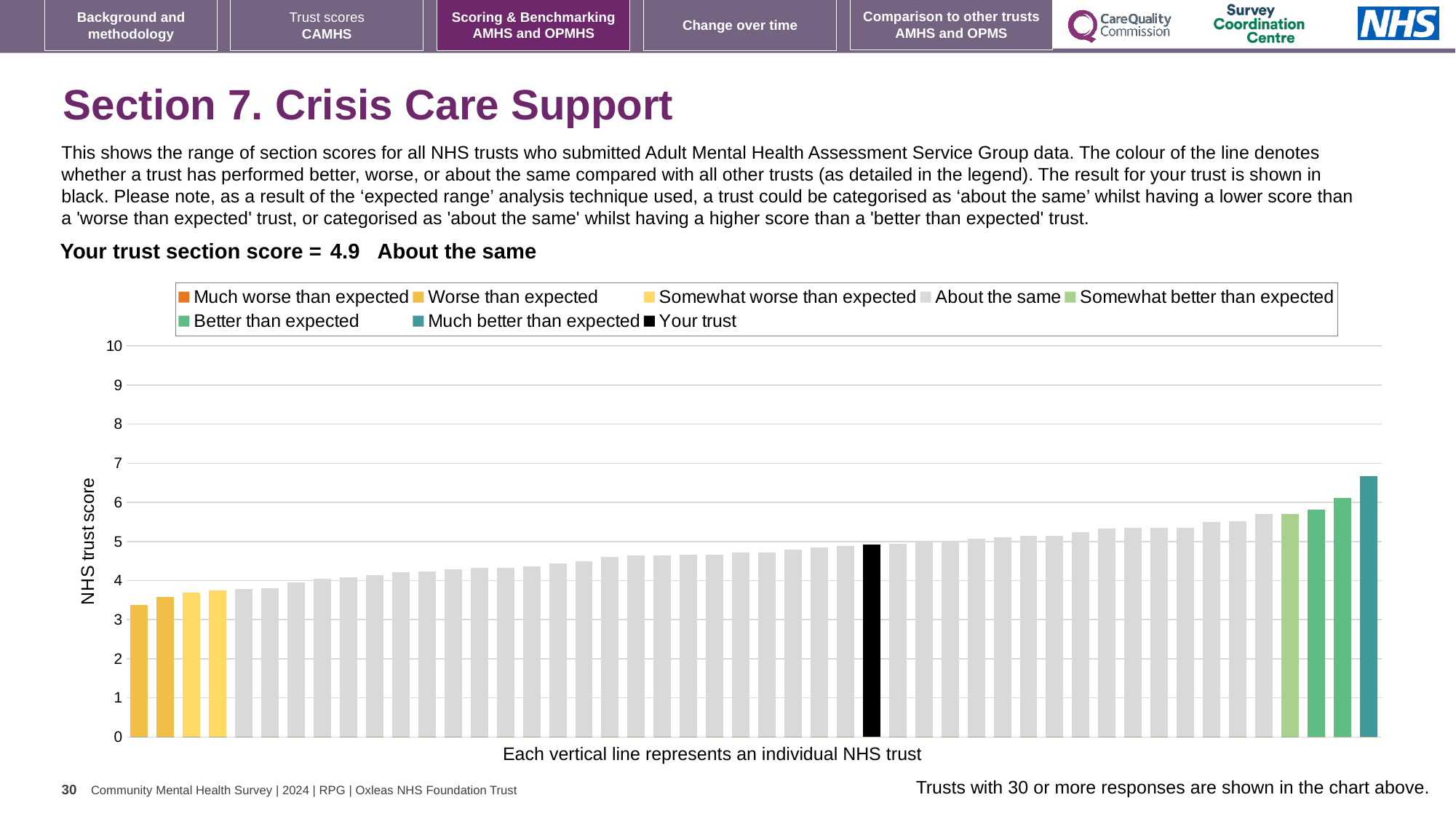
What is the label on the vertical axis of the chart? NHS trust score Do the bar values rise or fall from left to right along the x axis? Rise What kind of chart is shown on the slide? Bar chart Is the value for your trust (the black bar) greater or less than 5? less How many entries does the chart legend list? 8 Is the value of the shortest bar greater or less than 4? less What is the section score for your trust shown on the slide? 4.9 Is the value of the tallest bar greater or less than 6? greater Which is larger, the value for your trust or the value of the tallest bar? The tallest bar How many bars are coloured as 'Much worse than expected'? 0 Which legend category does the tallest bar belong to? Much better than expected